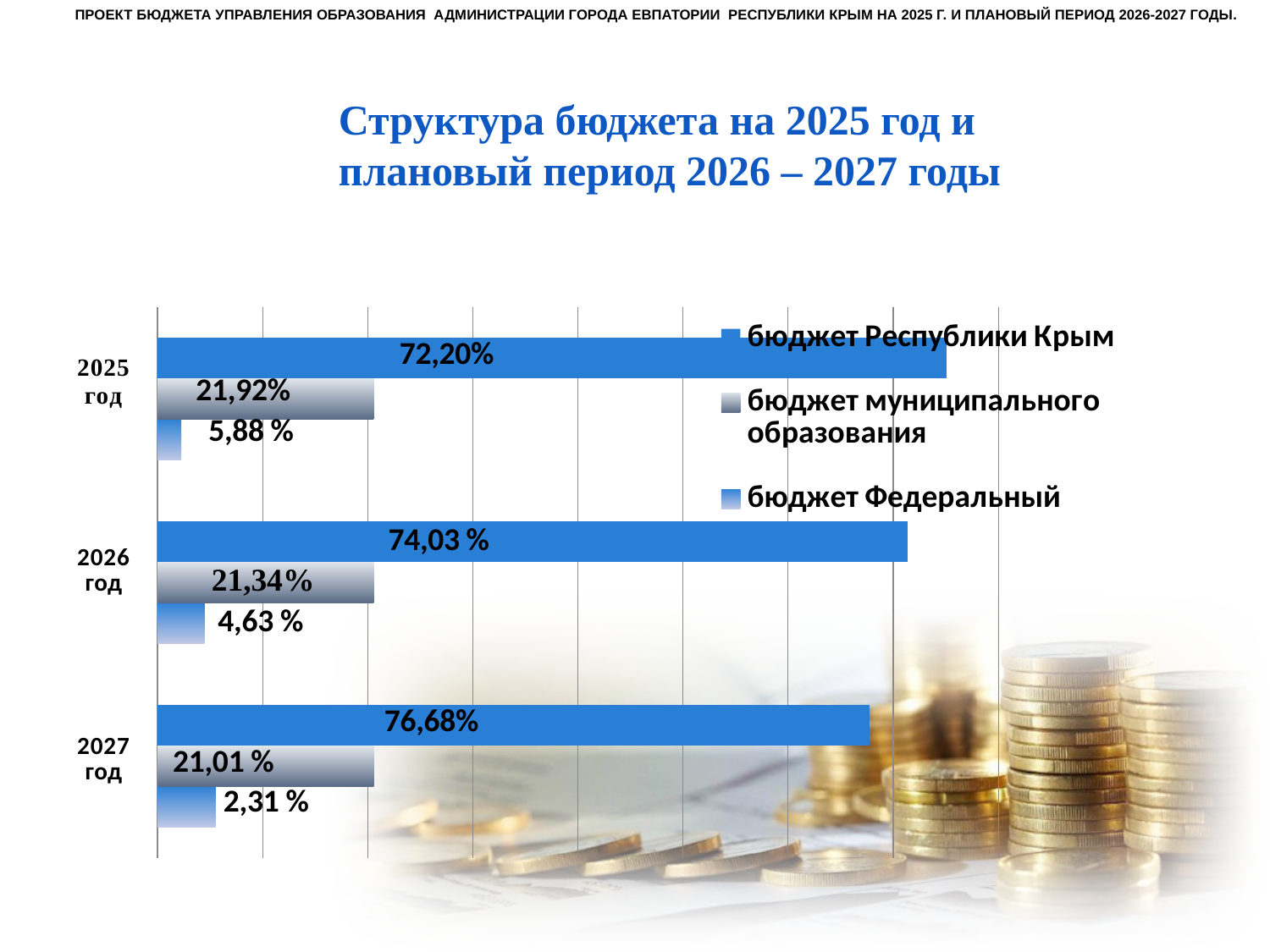
How many year categories are plotted on the chart? 3 What is the value for бюджет Республики Крым in 2025 год? 72,20% Which is larger in 2026 год: бюджет муниципального образования or бюджет Федеральный? бюджет муниципального образования What is the value for бюджет Федеральный in 2027 год? 2,31 % What is the value for бюджет Федеральный in 2025 год? 5,88 % What kind of chart is shown on the slide? bar chart How many series does the legend list? 3 In which year is the value for бюджет Республики Крым the highest? 2027 год Which series is shown in the darkest blue colour in the legend? бюджет Республики Крым Does the value for бюджет Федеральный rise or fall from 2025 год to 2027 год? fall In which year is the value for бюджет Федеральный the lowest? 2027 год What is the value for бюджет муниципального образования in 2026 год? 21,34%